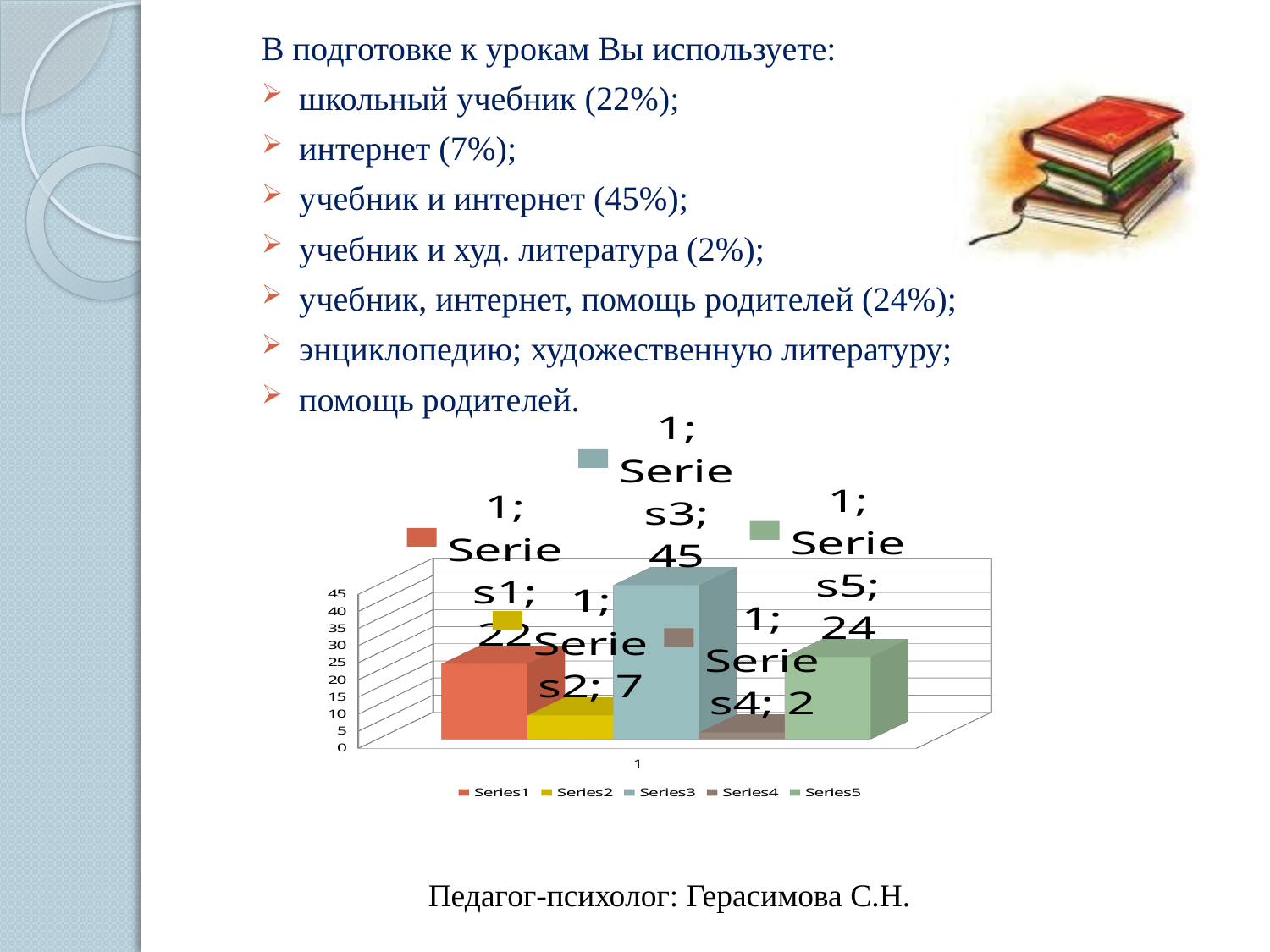
Which series has the lowest value? Series4 What is the value for Series2? 7 What is the value for Series5? 24 How many series does the chart legend list? 5 What is the value for Series3? 45 Which is larger, the value for Series5 or the value for Series1? Series5 What type of chart is shown on the slide? bar chart What is the value for Series1? 22 What is the difference between the values for Series3 and Series1? 23 What is the maximum value shown on the vertical axis? 45 What is the value for Series4? 2 Which series has the highest value? Series3